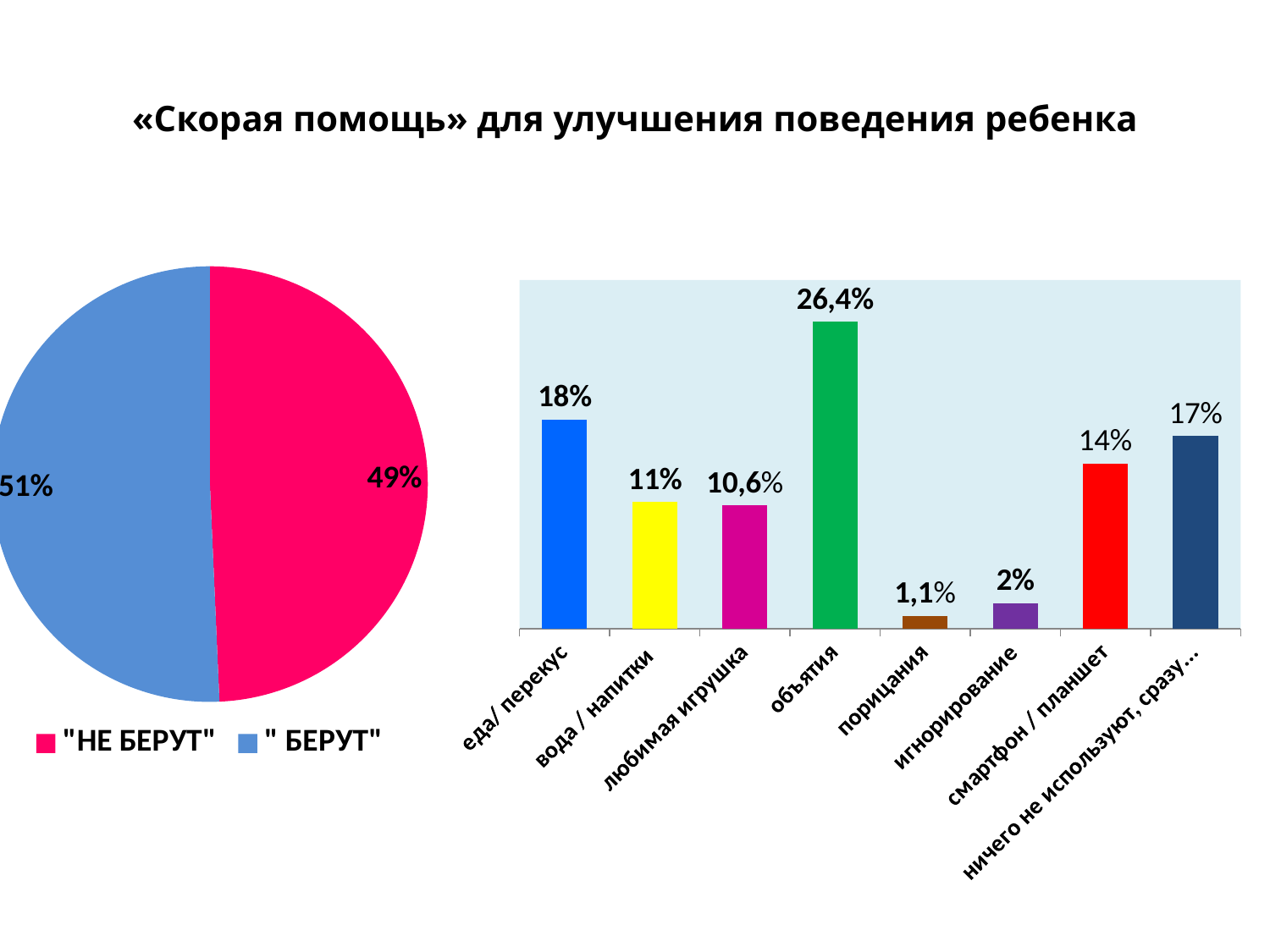
In the bar chart on the right, what is the value for объятия? 26,4% In the pie chart on the left, what share is labelled "БЕРУТ"? 51% How many categories are shown in the bar chart on the right? 8 In the pie chart on the left, what share is labelled "НЕ БЕРУТ"? 49% In the bar chart on the right, which is larger, the value for вода / напитки or the value for любимая игрушка? вода / напитки In the pie chart on the left, which slice is larger, "НЕ БЕРУТ" or "БЕРУТ"? "БЕРУТ" What kind of chart is shown on the right side of the slide? Bar chart How many entries does the legend of the pie chart on the left list? 2 In the bar chart on the right, which category has the lowest value? порицания In the bar chart on the right, what is the value for еда/ перекус? 18% In the bar chart on the right, which category has the highest value? объятия In the bar chart on the right, what is the difference between the values for еда/ перекус and смартфон / планшет? 4%